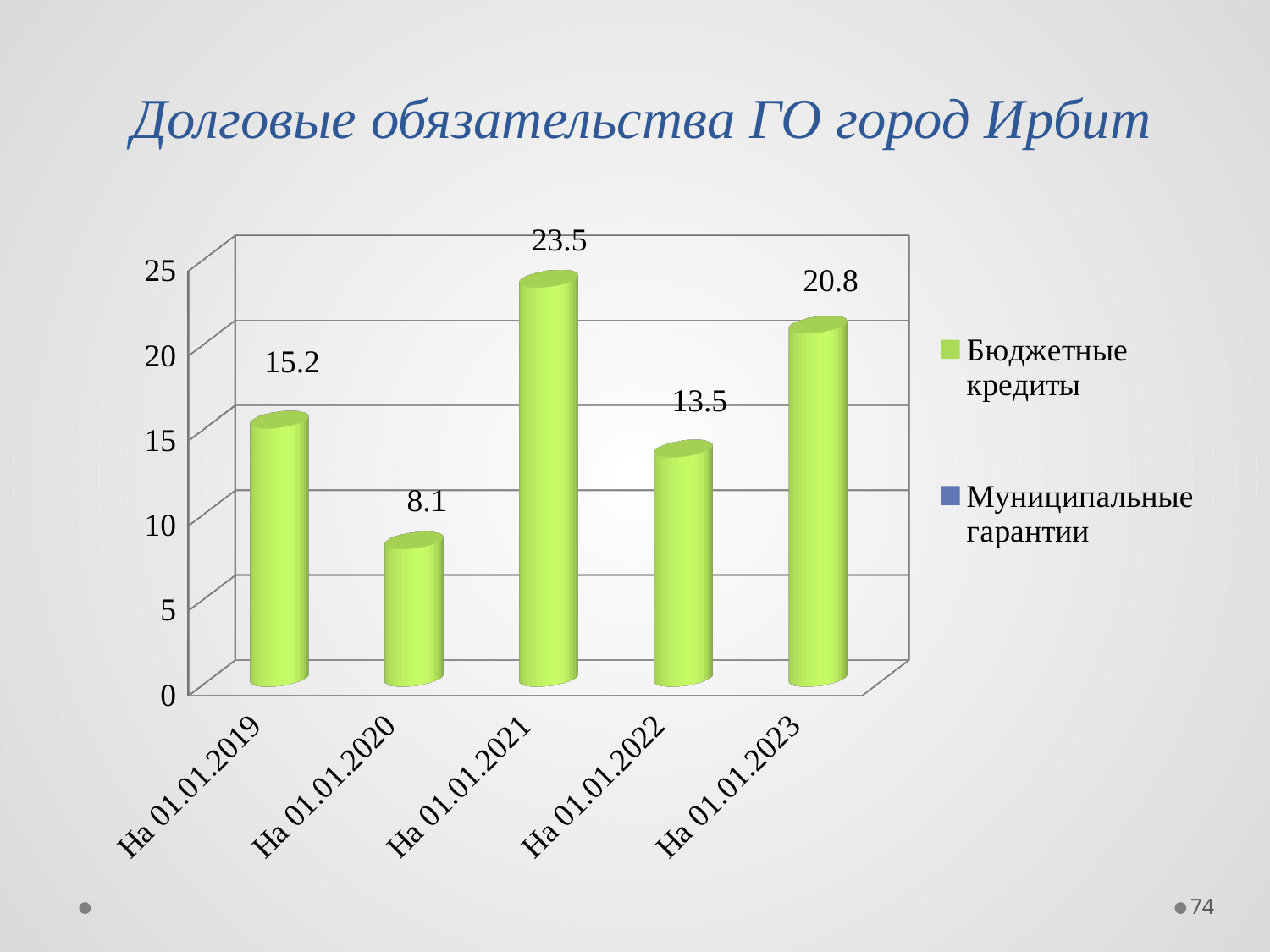
What is the value of Бюджетные кредиты for На 01.01.2023? 20.8 Which date has the lowest value of Бюджетные кредиты? На 01.01.2020 Which is larger, the Бюджетные кредиты value for На 01.01.2019 or for На 01.01.2022? На 01.01.2019 What is the value of Бюджетные кредиты for На 01.01.2019? 15.2 What kind of chart is shown on the slide? bar chart How many dates are shown on the x axis? 5 What is the title of the slide? Долговые обязательства ГО город Ирбит What is the difference between the Бюджетные кредиты values for На 01.01.2021 and На 01.01.2020? 15.4 What is the value of Бюджетные кредиты for На 01.01.2021? 23.5 Which date has the highest value of Бюджетные кредиты? На 01.01.2021 How many series does the legend list? 2 Is the value for На 01.01.2023 greater or less than 20? greater